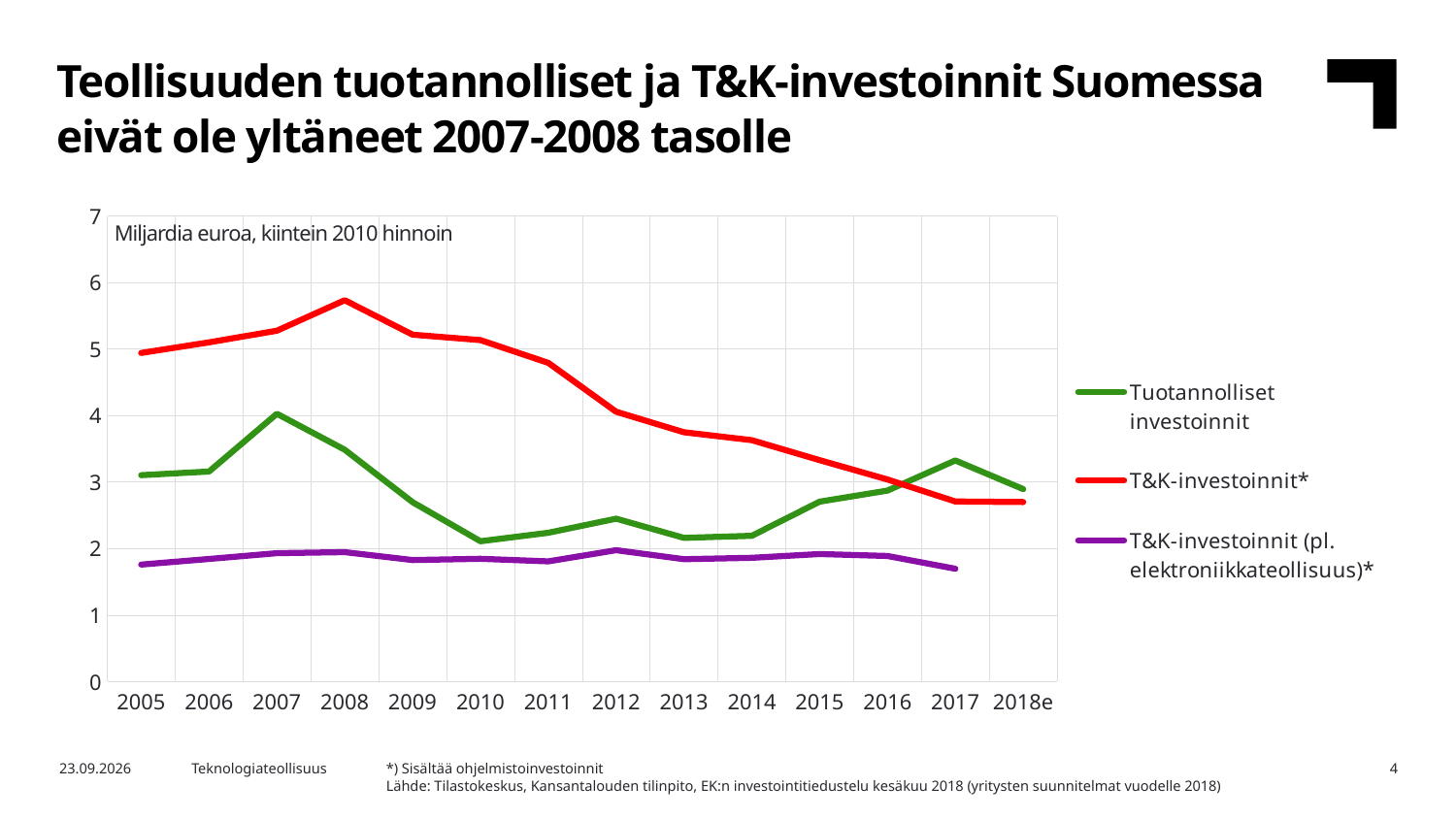
In 2017, which is larger: Tuotannolliset investoinnit or T&K-investoinnit*? Tuotannolliset investoinnit What unit is stated in the label inside the chart area? Miljardia euroa, kiintein 2010 hinnoin In which year does the T&K-investoinnit* series reach its highest value? 2008 Is the value for T&K-investoinnit* in 2017 greater or less than 3? less How many years are shown on the x axis? 14 How many series does the legend list? 3 Does the T&K-investoinnit* series rise or fall from 2008 to 2017? fall In which year does the Tuotannolliset investoinnit series reach its highest value? 2007 What kind of chart is shown on the slide? line chart Is the value for Tuotannolliset investoinnit in 2010 greater or less than 3? less In which year is the T&K-investoinnit (pl. elektroniikkateollisuus)* series at its lowest? 2017 Is the value for T&K-investoinnit* in 2008 greater or less than 5? greater